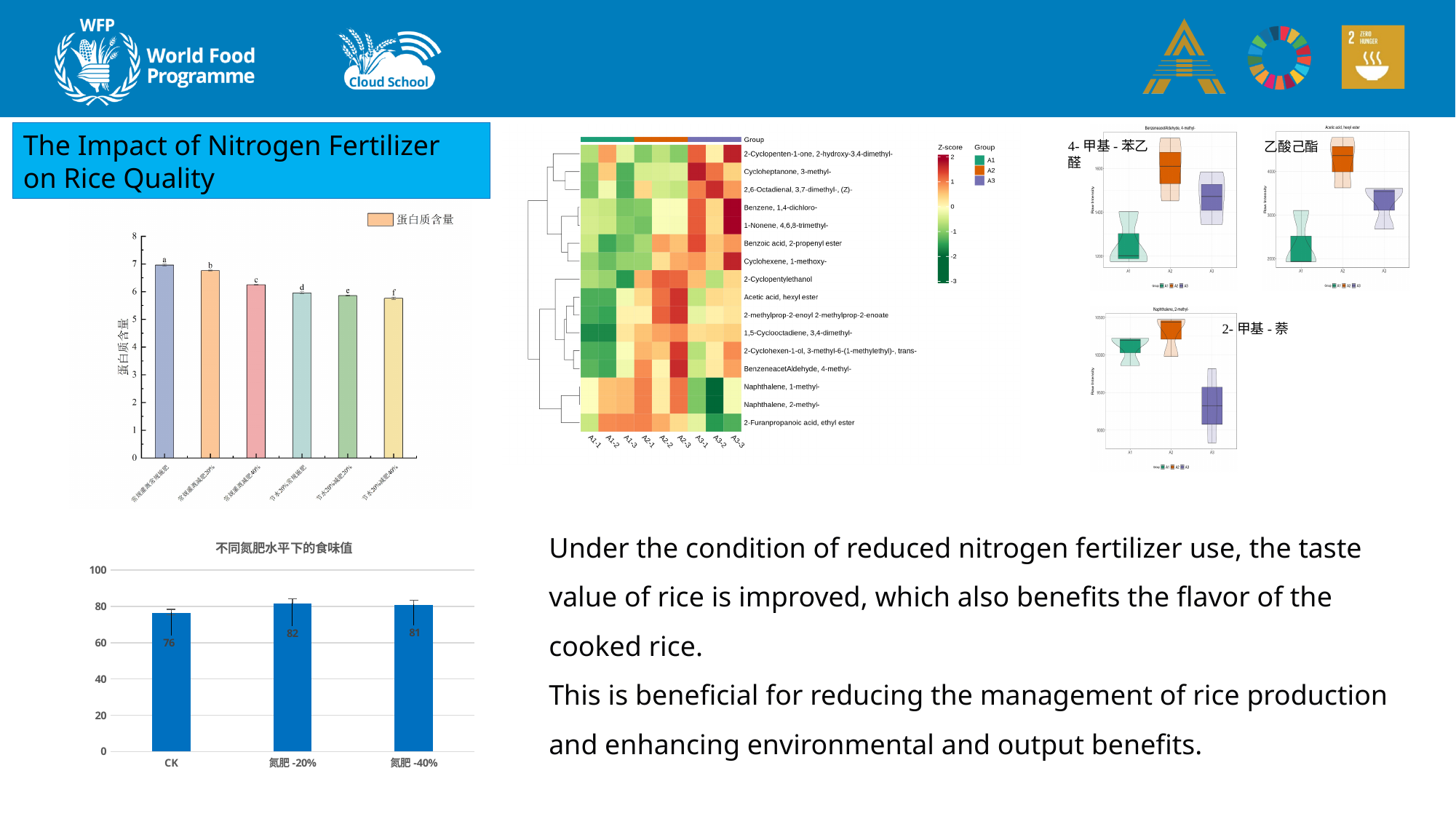
In the bar chart titled 不同氮肥水平下的食味值, which category has the highest value? 氮肥 -20% How many groups does the Group legend of the heatmap list? 3 What kind of chart is the chart titled 不同氮肥水平下的食味值? bar chart In the protein content (蛋白质含量) bar chart at the top left, is the value of the leftmost bar (labeled a) greater or less than 6? greater In the protein content (蛋白质含量) bar chart at the top left, how many bars are shown? 6 In the bar chart titled 不同氮肥水平下的食味值, what is the value for CK? 76 In the bar chart titled 不同氮肥水平下的食味值, which is larger, the value for CK or the value for 氮肥 -40%? 氮肥 -40% In the bar chart titled 不同氮肥水平下的食味值, what is the value for 氮肥 -40%? 81 In the bar chart titled 不同氮肥水平下的食味值, which category has the lowest value? CK In the bar chart titled 不同氮肥水平下的食味值, what is the value for 氮肥 -20%? 82 How many categories are shown in the bar chart titled 不同氮肥水平下的食味值? 3 In the bar chart titled 不同氮肥水平下的食味值, what is the difference between the values for 氮肥 -20% and CK? 6